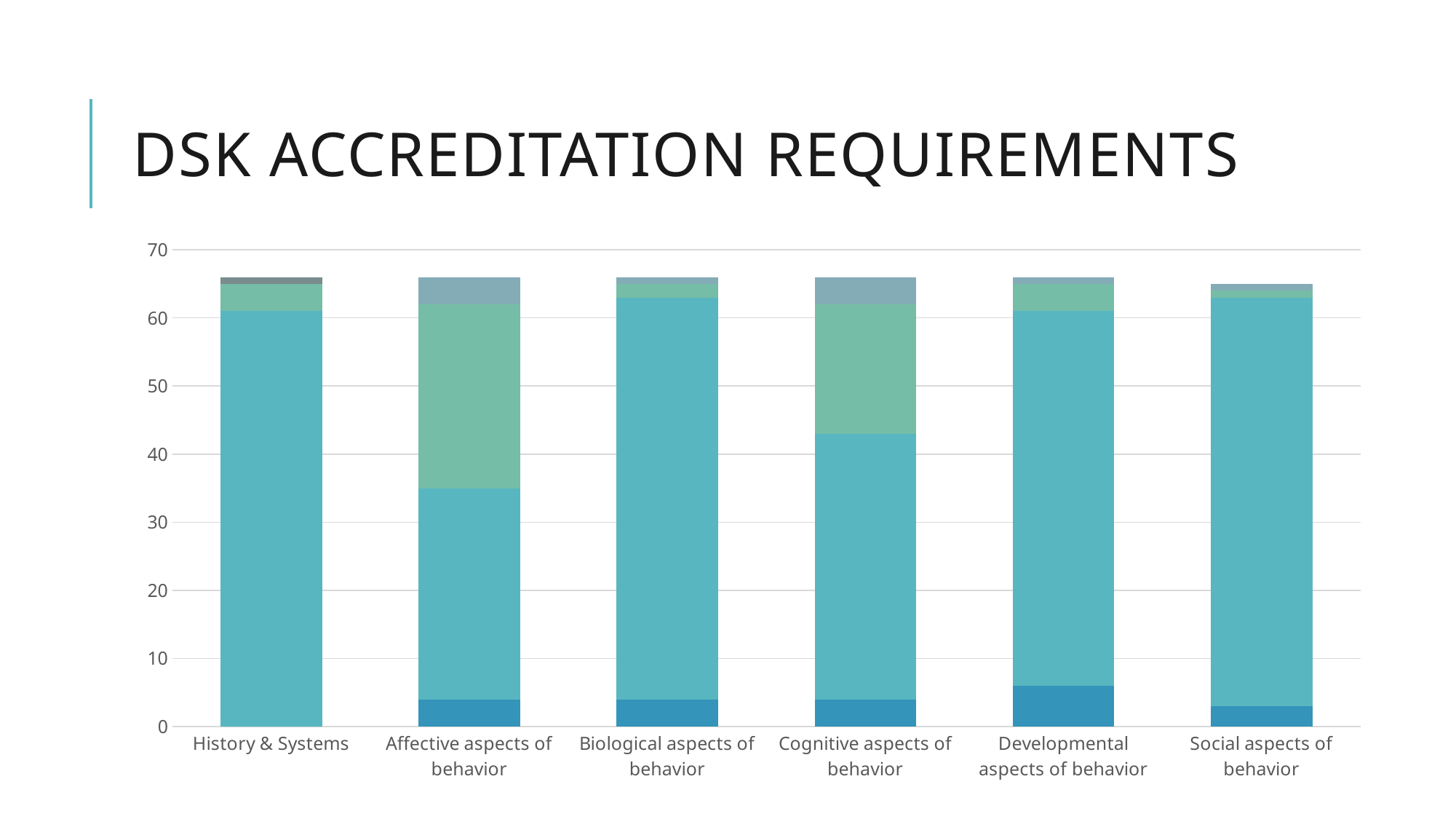
What kind of chart is shown on the slide? bar chart What is the title of the slide containing the chart? DSK Accreditation Requirements Is the total bar height for History & Systems greater or less than 60? greater How many categories are shown on the x axis of the chart? 6 Is the total bar height for Social aspects of behavior greater or less than 70? less Does the chart include a legend identifying the stacked segments? No Is the total bar height for Affective aspects of behavior greater or less than 40? greater